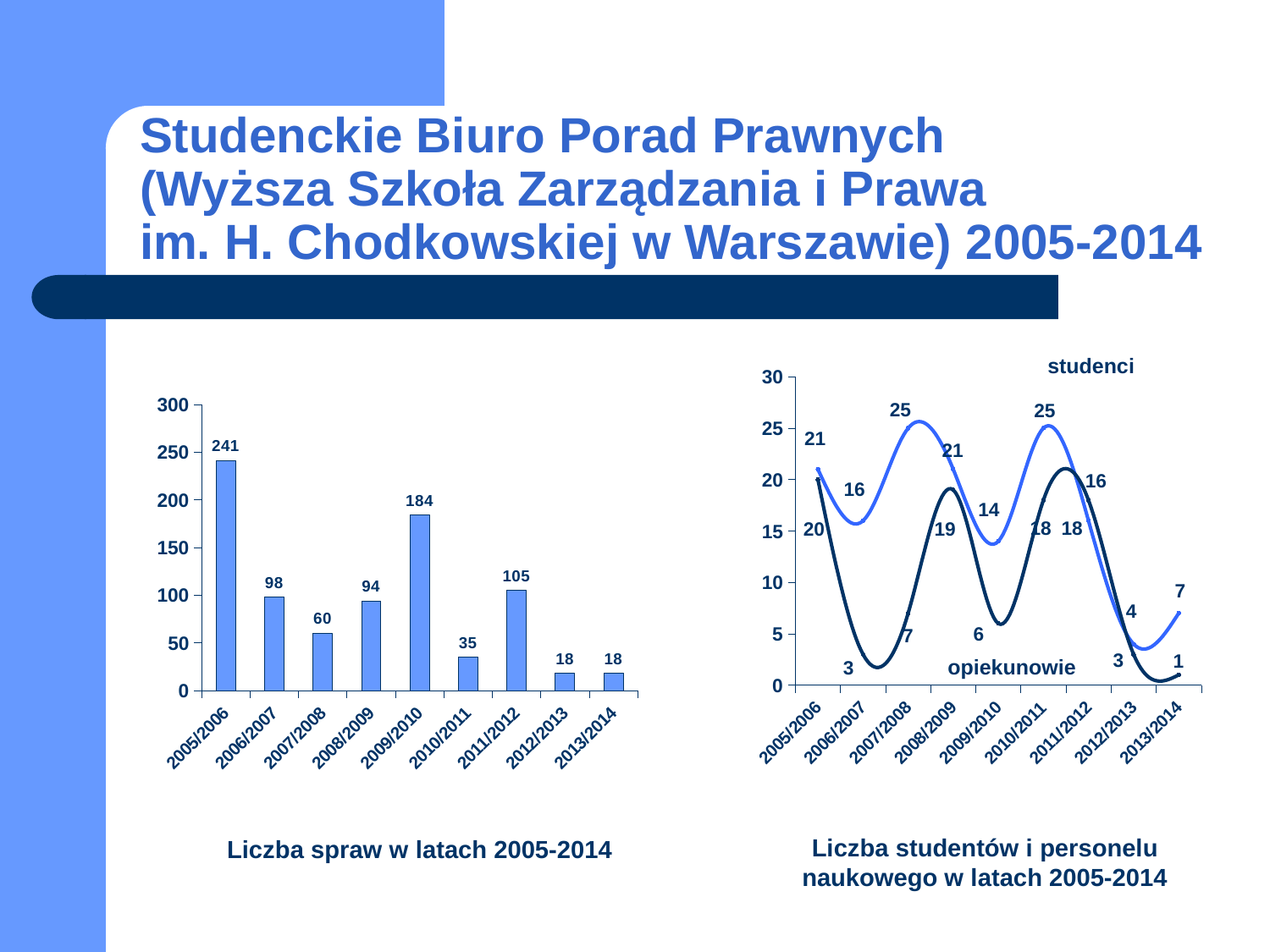
In the right chart (Liczba studentów i personelu naukowego), what is the value of the opiekunowie series for 2013/2014? 1 In the right chart (Liczba studentów i personelu naukowego), what is the value of the studenci series for 2009/2010? 14 In the left chart (Liczba spraw w latach 2005-2014), what is the value for 2009/2010? 184 In the right chart (Liczba studentów i personelu naukowego), what is the difference between the studenci and opiekunowie values for 2006/2007? 13 What kind of chart is the right chart (Liczba studentów i personelu naukowego)? line chart In the left chart (Liczba spraw w latach 2005-2014), which is larger, the value for 2007/2008 or the value for 2008/2009? 2008/2009 In the left chart (Liczba spraw w latach 2005-2014), what is the difference between the values for 2005/2006 and 2006/2007? 143 In the left chart (Liczba spraw w latach 2005-2014), how many years are shown on the x axis? 9 In the right chart (Liczba studentów i personelu naukowego), which year has the lowest value for the opiekunowie series? 2013/2014 What kind of chart is the left chart (Liczba spraw w latach 2005-2014)? bar chart In the left chart (Liczba spraw w latach 2005-2014), which year has the highest value? 2005/2006 How many series are plotted in the right chart (Liczba studentów i personelu naukowego)? 2